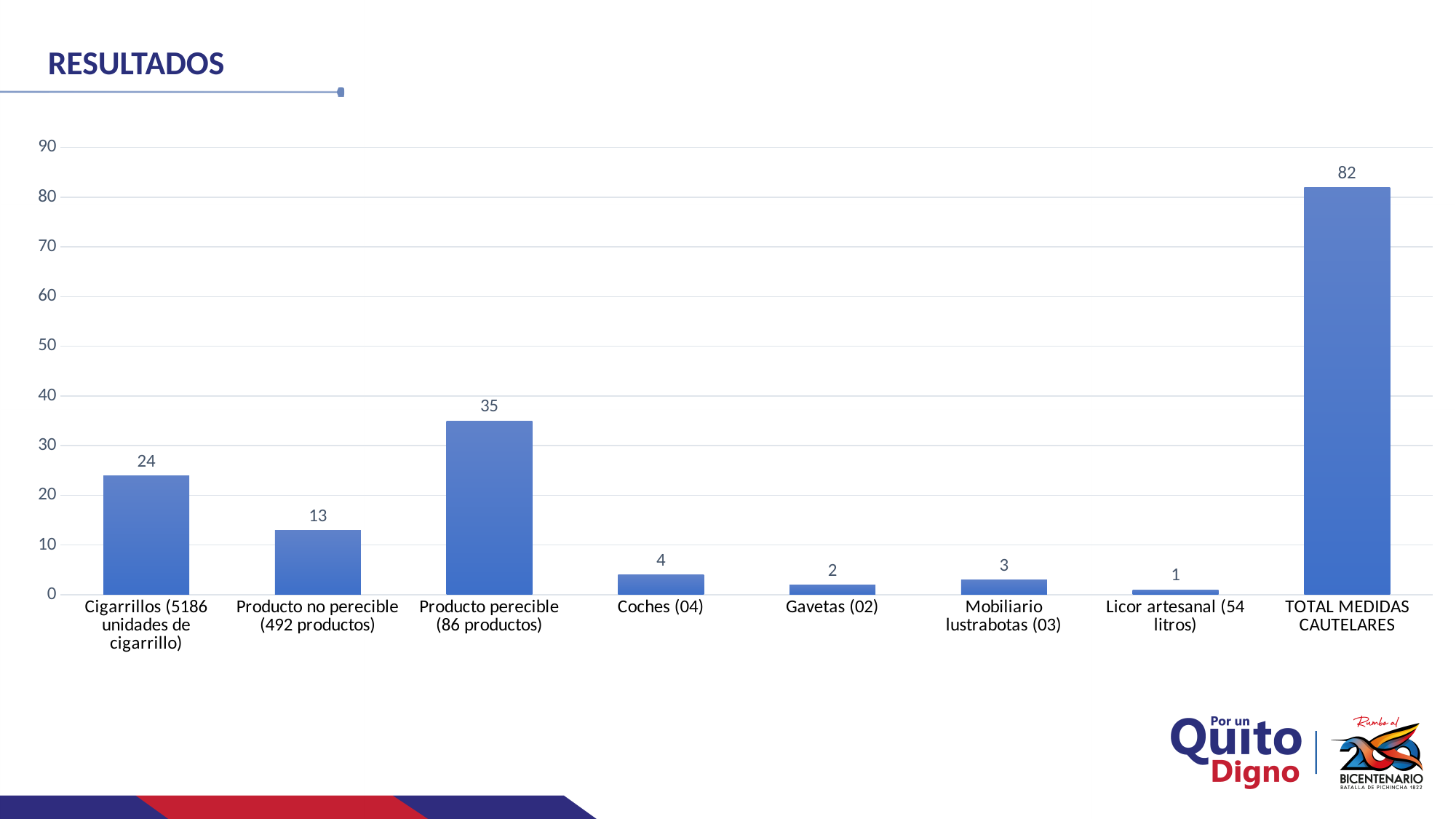
Which category has the lowest value? Licor artesanal (54 litros) How many categories are shown on the x axis? 8 What is the value for Gavetas (02)? 2 Which is larger, the value for Coches (04) or the value for Mobiliario lustrabotas (03)? Coches (04) What is the value for TOTAL MEDIDAS CAUTELARES? 82 Which category has the highest value? TOTAL MEDIDAS CAUTELARES What is the title of the slide containing the chart? RESULTADOS What is the value for Producto perecible (86 productos)? 35 What kind of chart is shown on the slide? bar chart What is the value for Cigarrillos (5186 unidades de cigarrillo)? 24 What is the difference between the values for Producto perecible (86 productos) and Producto no perecible (492 productos)? 22 Is the value for Cigarrillos (5186 unidades de cigarrillo) greater or less than 20? greater